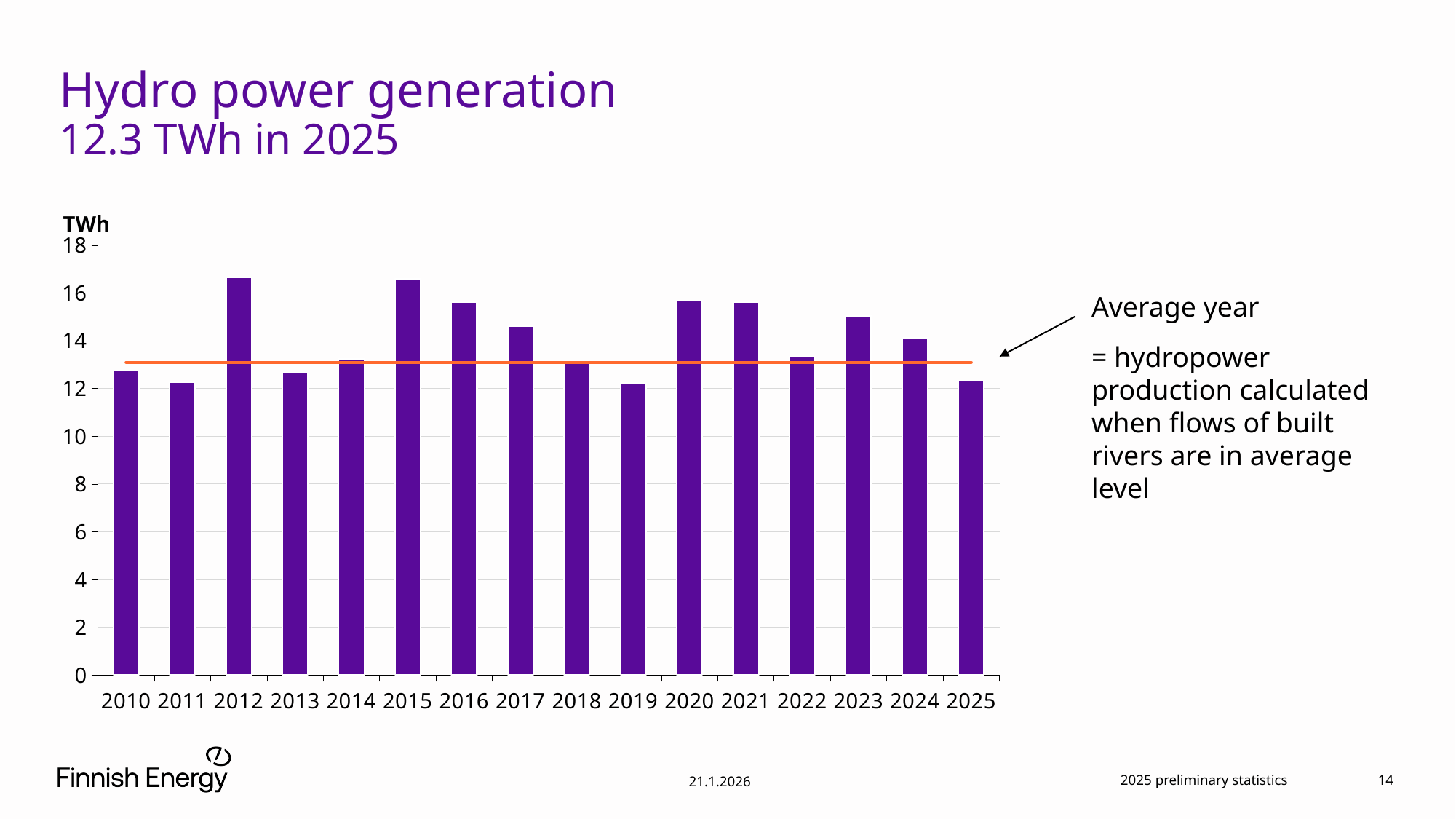
Is the value for 2023 greater or less than 14? greater What kind of chart is shown on the slide? bar chart Which year has the larger value, 2012 or 2013? 2012 How many years are plotted on the x axis of the chart? 16 What does the orange horizontal line on the chart represent? Average year What was hydro power generation in 2025 according to the slide? 12.3 TWh Is the value for 2010 greater or less than 14? less Is the value for 2012 greater or less than 16? greater Which year has the larger value, 2017 or 2019? 2017 What unit is shown on the y axis of the chart? TWh